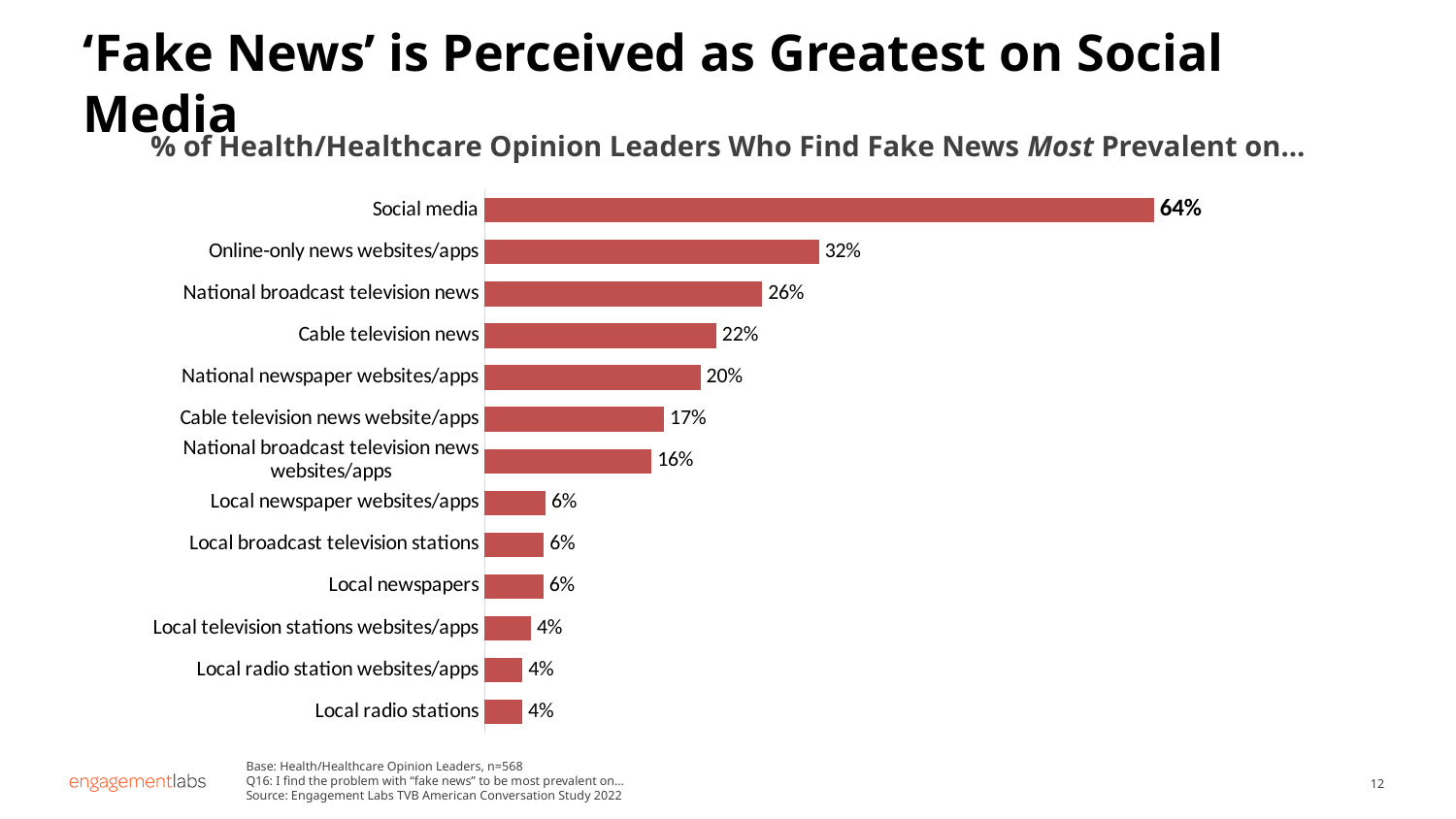
What is the value for Cable television news? 22% What percentage of Health/Healthcare Opinion Leaders find fake news most prevalent on social media? 64% What is the value for Local radio stations? 4% Which category has the highest value? Social media What is the difference between the values for National broadcast television news and National newspaper websites/apps? 6% What kind of chart is shown on the slide? Bar chart How many categories are shown on the chart? 13 What is the value for National broadcast television news websites/apps? 16% What is the value for Online-only news websites/apps? 32% What is the lowest value shown on the chart? 4% What is the difference between the values for Social media and Online-only news websites/apps? 32% Which is larger, the value for Cable television news website/apps or the value for Local newspapers? Cable television news website/apps